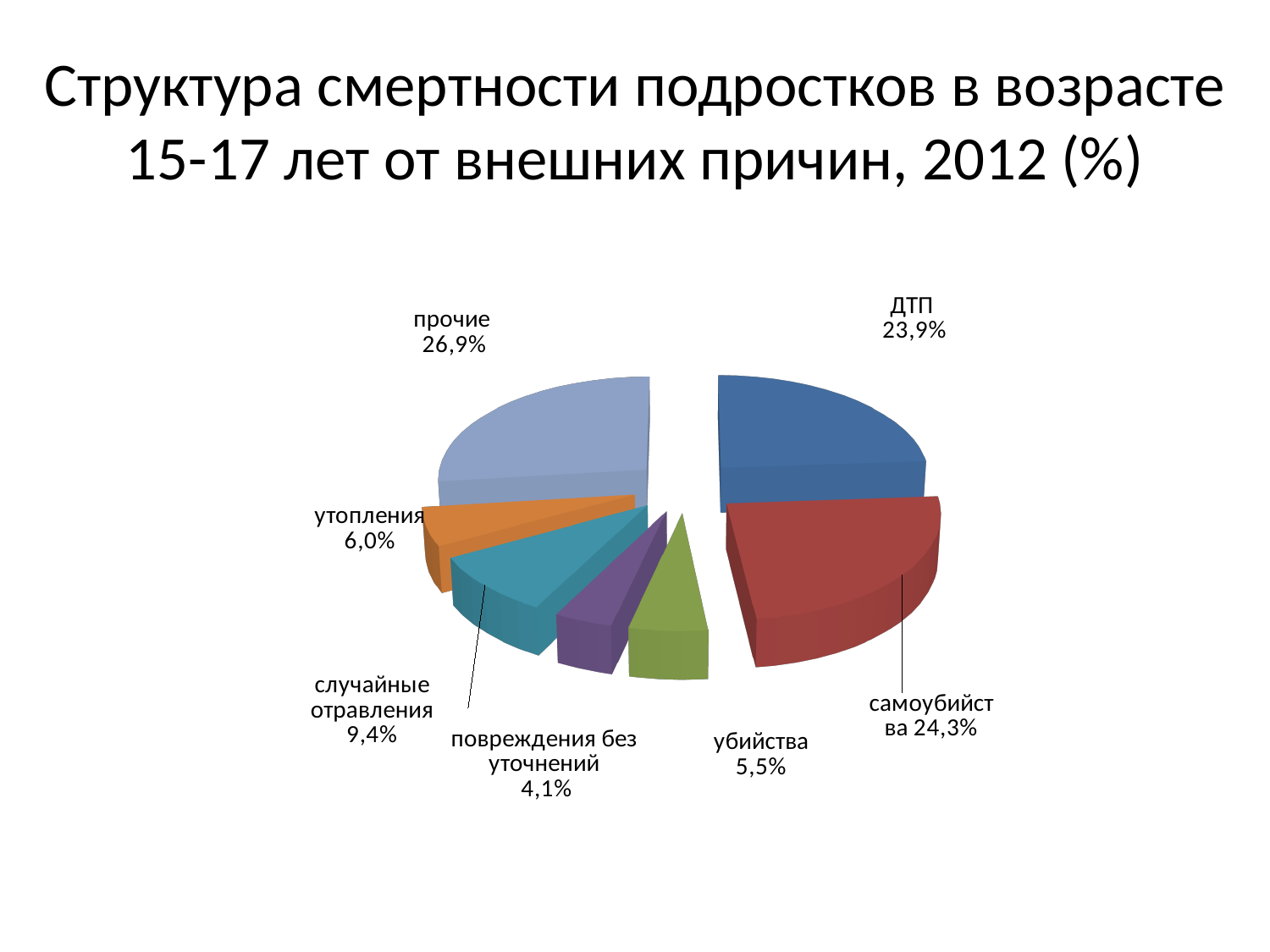
What is the value shown for самоубийства? 24,3% What kind of chart is shown on the slide? pie chart Which category has the largest share of the pie? прочие What is the value shown for случайные отравления? 9,4% What is the title of the chart on the slide? Структура смертности подростков в возрасте 15-17 лет от внешних причин, 2012 (%) What is the difference between the share for прочие and the share for самоубийства? 2,6% Which category has the smallest share of the pie? повреждения без уточнений What share of the pie does убийства account for? 5,5% How many categories (slices) does the pie chart have? 7 Which is larger, the share for ДТП or the share for самоубийства? самоубийства What share of the pie does ДТП account for? 23,9% What is the value shown for утопления? 6,0%